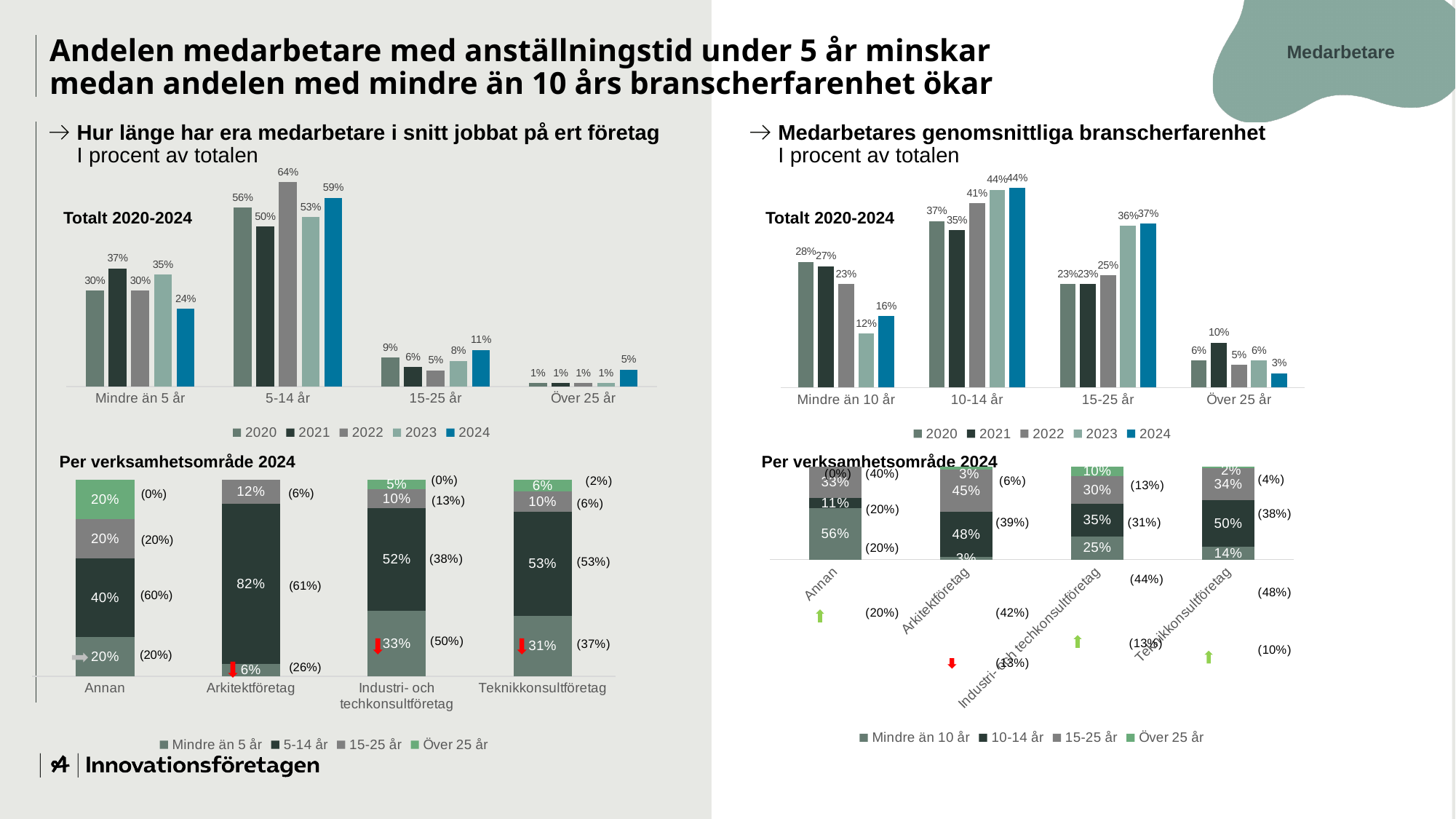
In the top-right chart 'Medarbetares genomsnittliga branscherfarenhet' (Totalt 2020-2024), what is the difference between the 2020 and 2024 values for 'Mindre än 10 år'? 12% In the top-left chart 'Hur länge har era medarbetare i snitt jobbat på ert företag' (Totalt 2020-2024), what is the value for 'Mindre än 5 år' in 2024? 24% In the bottom-left chart 'Per verksamhetsområde 2024' (left side), which is larger: the 'Mindre än 5 år' share for Industri- och techkonsultföretag or for Arkitektföretag? Industri- och techkonsultföretag In the bottom-left chart 'Per verksamhetsområde 2024' (left side), how many categories are shown on the x axis? 4 What kind of chart is the top-right chart 'Medarbetares genomsnittliga branscherfarenhet' (Totalt 2020-2024)? Bar chart In the top-left chart 'Hur länge har era medarbetare i snitt jobbat på ert företag' (Totalt 2020-2024), what is the difference between the 2021 and 2024 values for 'Mindre än 5 år'? 13% In the top-left chart 'Hur länge har era medarbetare i snitt jobbat på ert företag' (Totalt 2020-2024), how many series does the legend list? 5 In the top-right chart 'Medarbetares genomsnittliga branscherfarenhet' (Totalt 2020-2024), which year has the lowest value for 'Mindre än 10 år'? 2023 In the top-left chart 'Hur länge har era medarbetare i snitt jobbat på ert företag' (Totalt 2020-2024), what is the value for 'Över 25 år' in 2024? 5% In the top-right chart 'Medarbetares genomsnittliga branscherfarenhet' (Totalt 2020-2024), what is the value for '15-25 år' in 2024? 37% In the bottom-left chart 'Per verksamhetsområde 2024' (left side), what is the '5-14 år' share for Arkitektföretag? 82% In the top-left chart 'Hur länge har era medarbetare i snitt jobbat på ert företag' (Totalt 2020-2024), which year has the highest value for '5-14 år'? 2022